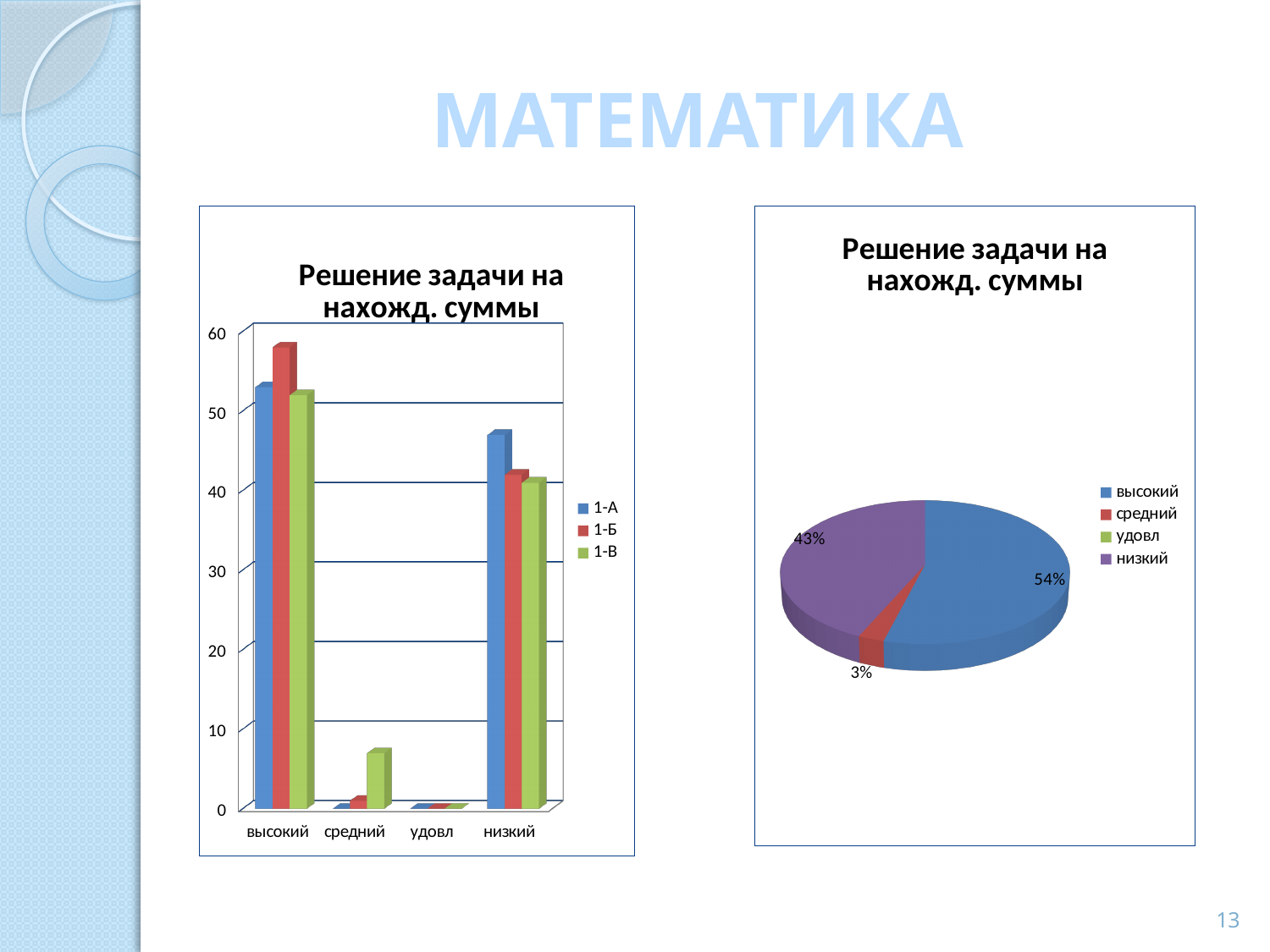
In the bar chart on the left, which series has the highest bar in the высокий category? 1-Б In the bar chart on the left, is the value for 1-В in the средний category greater or less than 10? less In the bar chart on the left, how many categories are shown on the x axis? 4 In the pie chart on the right, what share does the средний slice have? 3% In the pie chart on the right, what share does the высокий slice have? 54% In the bar chart on the left, is the value for 1-Б in the высокий category greater or less than 50? greater In the bar chart on the left, how many series does the legend list? 3 In the pie chart on the right, which slice is the largest? высокий In the pie chart on the right, what share does the низкий slice have? 43% What kind of chart is the chart on the left of the slide? bar chart In the pie chart on the right, what is the difference between the высокий share and the низкий share? 11% What kind of chart is the chart on the right of the slide? pie chart